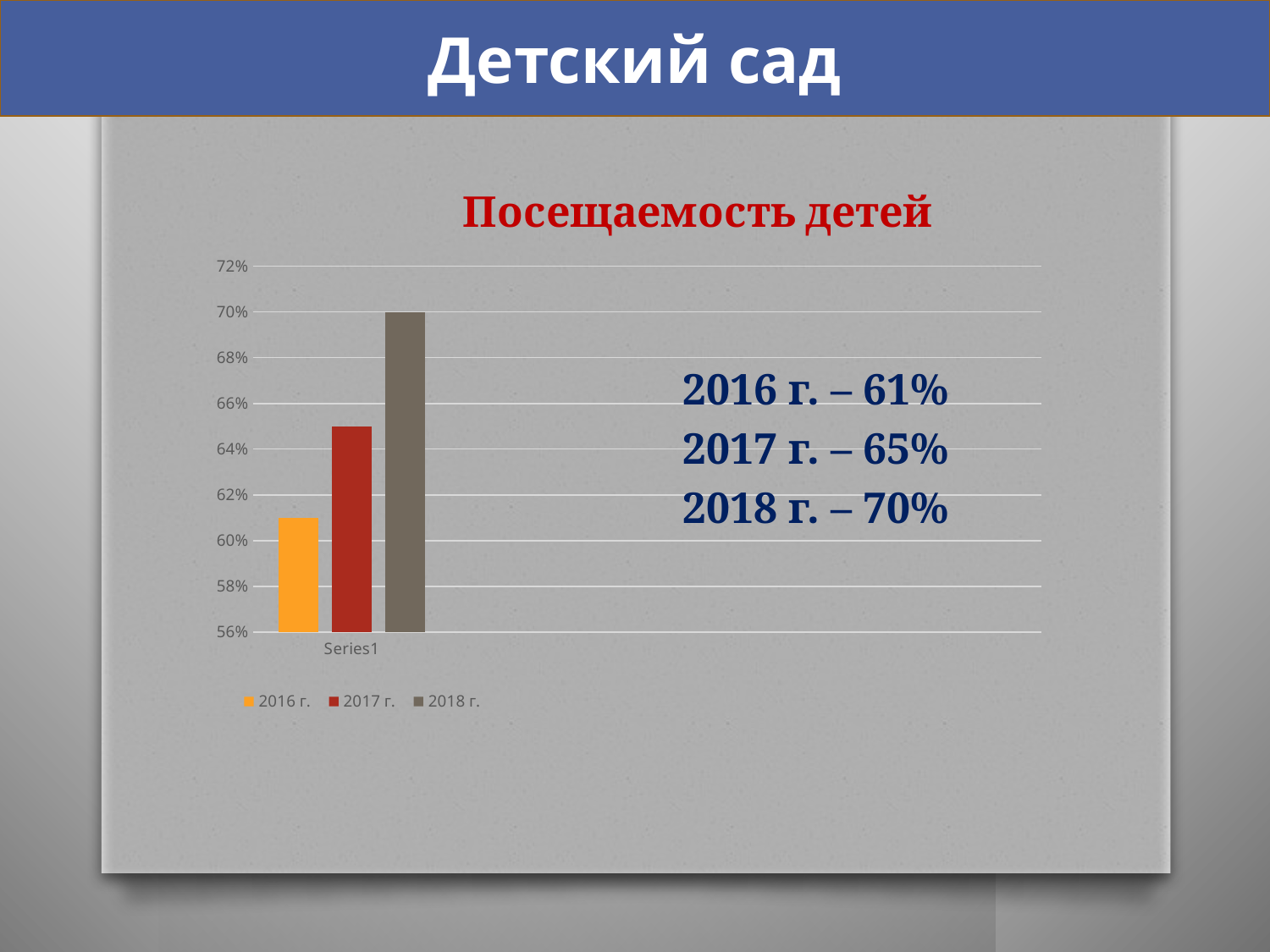
What is the difference between the values for 2018 г. and 2016 г.? 9% What is the attendance value for 2016 г.? 61% How many series does the legend list? 3 What is the title of the chart? Посещаемость детей Which is larger, the value for 2017 г. or the value for 2016 г.? 2017 г. What is the attendance value for 2018 г.? 70% What is the attendance value for 2017 г.? 65% What type of chart is shown on the slide? bar chart Which colour is used for the 2018 г. bar? grey Which year has the highest attendance value? 2018 г. Which year has the lowest attendance value? 2016 г. Do the values rise or fall from 2016 г. to 2018 г.? rise